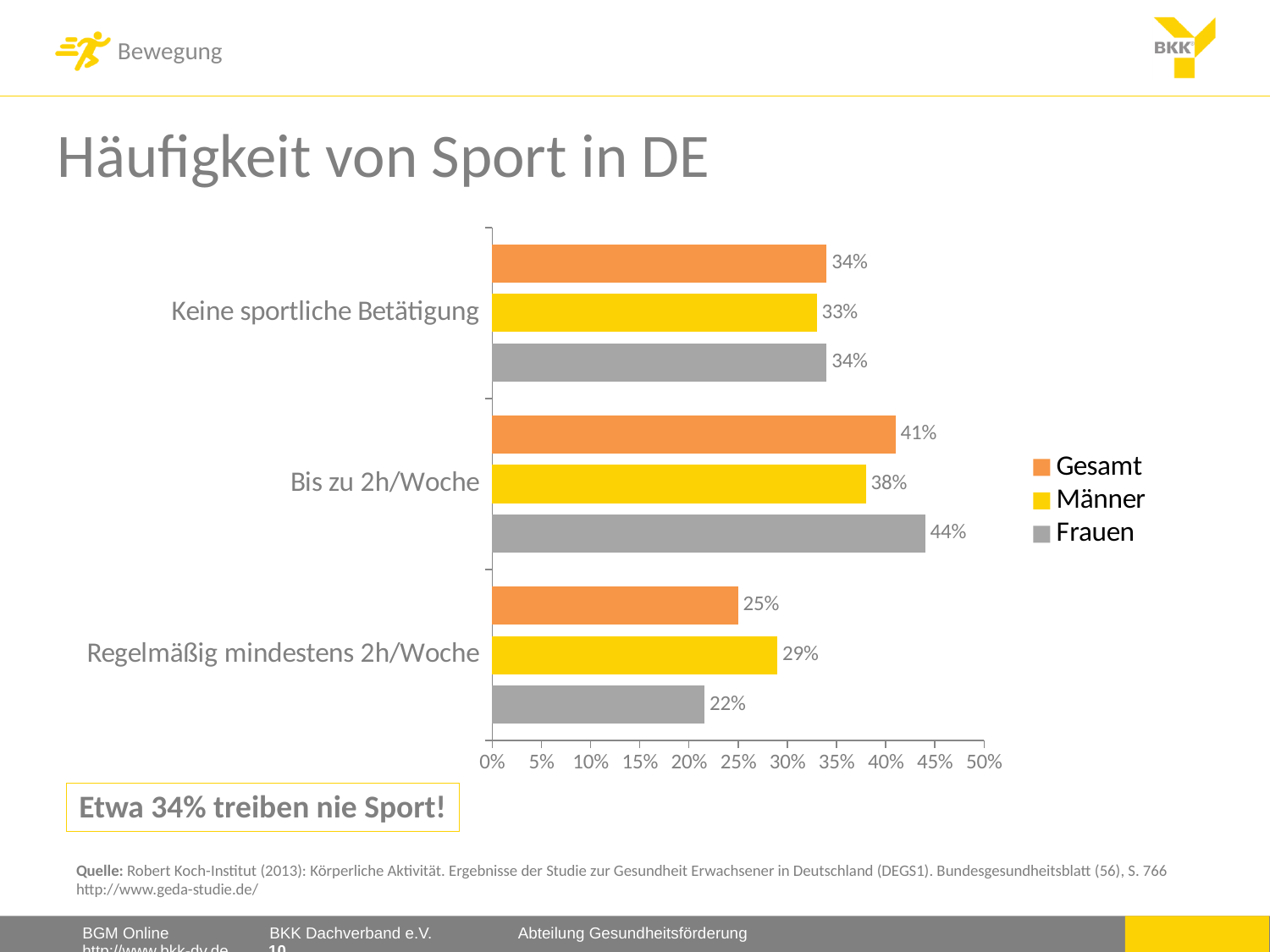
What is the value for Männer in the 'Regelmäßig mindestens 2h/Woche' category? 29% What is the value for Gesamt in the 'Keine sportliche Betätigung' category? 34% What is the difference between the Frauen and Männer values in the 'Bis zu 2h/Woche' category? 6% What is the value for Frauen in the 'Bis zu 2h/Woche' category? 44% Is the Gesamt value for 'Bis zu 2h/Woche' greater or less than 40%? greater How many series does the legend list? 3 Which category has the highest value for the Gesamt series? Bis zu 2h/Woche How many categories are shown on the chart? 3 In the 'Regelmäßig mindestens 2h/Woche' category, which is larger: Männer or Frauen? Männer What is the title of the slide containing the chart? Häufigkeit von Sport in DE Which category has the lowest value for the Frauen series? Regelmäßig mindestens 2h/Woche What kind of chart is shown on the slide? Bar chart